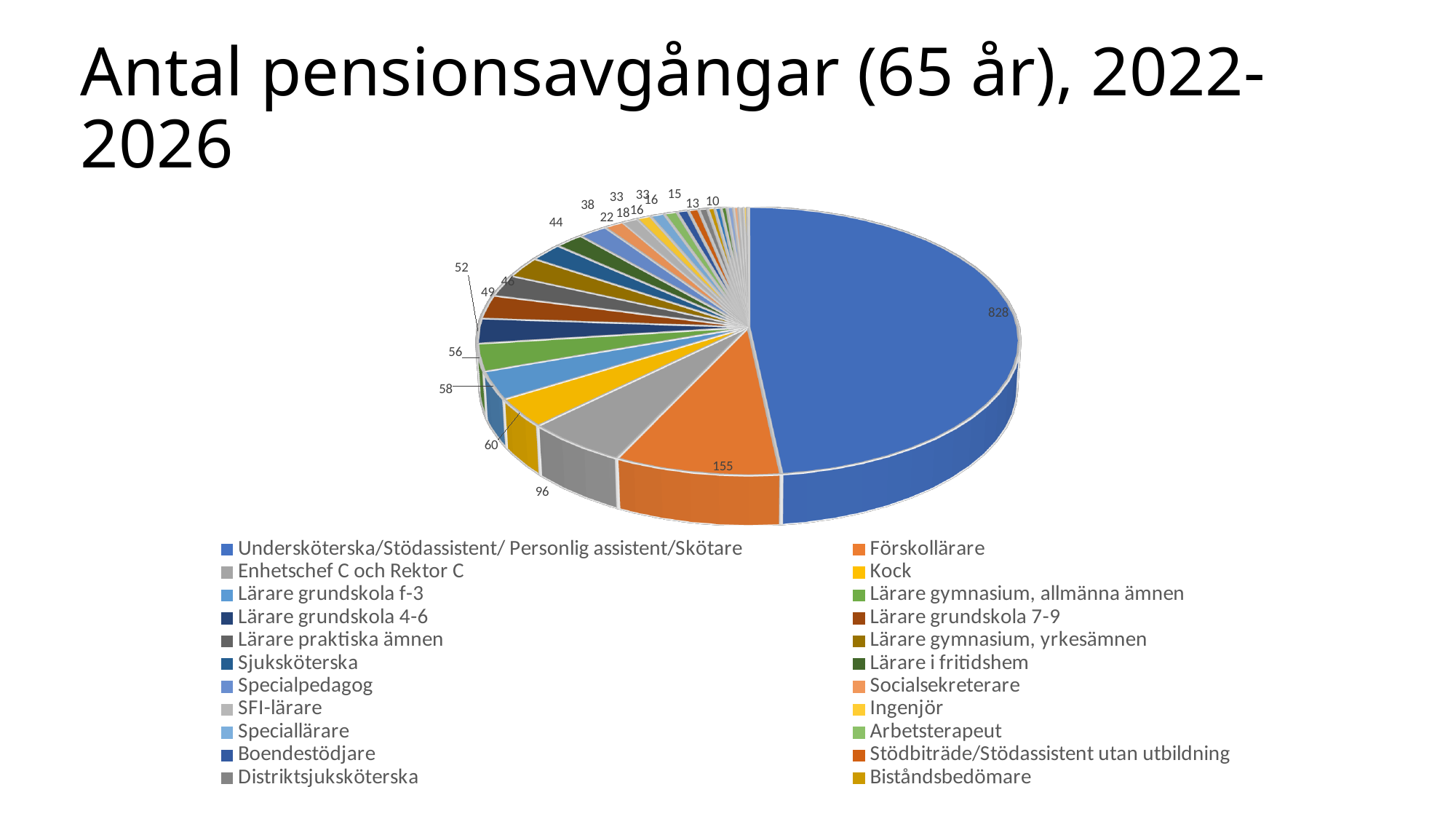
What colour is the slice for Förskollärare? orange What is the value for Enhetschef C och Rektor C? 96 What is the difference between the values for Undersköterska/Stödassistent/ Personlig assistent/Skötare and Förskollärare? 673 What is the title of the chart? Antal pensionsavgångar (65 år), 2022-2026 What is the difference between the values for Förskollärare and Enhetschef C och Rektor C? 59 How many categories does the legend list? 22 Which category has the largest slice of the pie? Undersköterska/Stödassistent/ Personlig assistent/Skötare What is the value for Undersköterska/Stödassistent/ Personlig assistent/Skötare? 828 What kind of chart is shown on the slide? pie chart What is the value for Förskollärare? 155 What is the value for Kock? 60 Which is larger, the value for Förskollärare or the value for Enhetschef C och Rektor C? Förskollärare